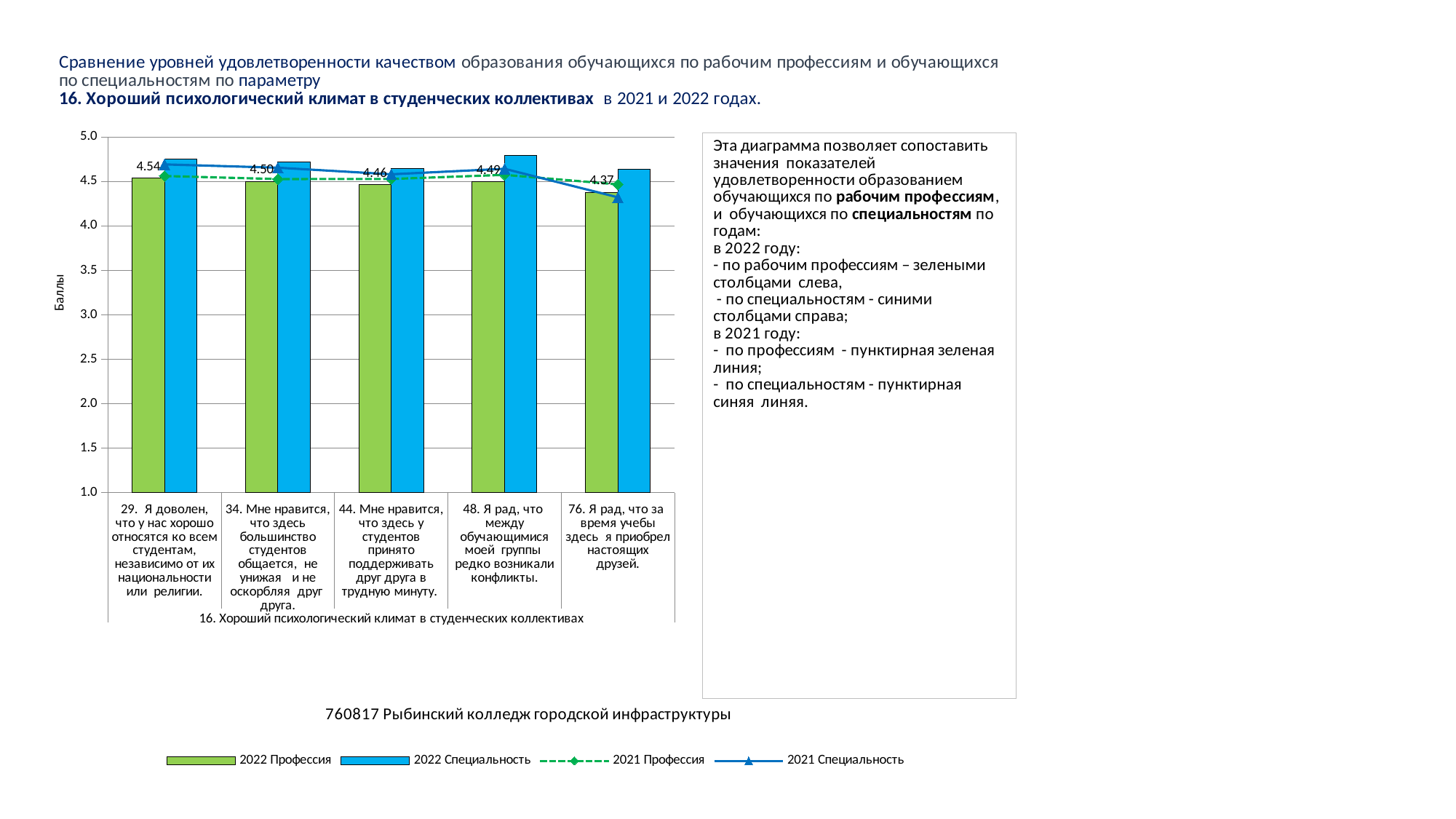
What is the 2022 Профессия value for the category "44. Мне нравится, что здесь у студентов принято поддерживать друг друга в трудную минуту."? 4.46 What is the 2022 Профессия value for the category "29. Я доволен, что у нас хорошо относятся ко всем студентам, независимо от их национальности или религии."? 4.54 What is the difference between the highest and lowest 2022 Профессия values (4.54 and 4.37)? 0.17 How many series does the legend list? 4 Which category has the highest 2022 Профессия value? 29. Я доволен, что у нас хорошо относятся ко всем студентам, независимо от их национальности или религии. What is the label of the vertical axis of the chart? Баллы Which category has the lowest 2022 Профессия value? 76. Я рад, что за время учебы здесь я приобрел настоящих друзей. How many categories are shown on the x axis of the chart? 5 What is the 2022 Профессия value for the category "76. Я рад, что за время учебы здесь я приобрел настоящих друзей."? 4.37 Which category has the taller 2022 Специальность bar: "48. Я рад, что между обучающимися моей группы редко возникали конфликты." or "76. Я рад, что за время учебы здесь я приобрел настоящих друзей."? 48. Я рад, что между обучающимися моей группы редко возникали конфликты. Is the 2022 Специальность value for "48. Я рад, что между обучающимися моей группы редко возникали конфликты." greater or less than 4.5? greater What kind of chart is shown on the slide? combination bar and line chart